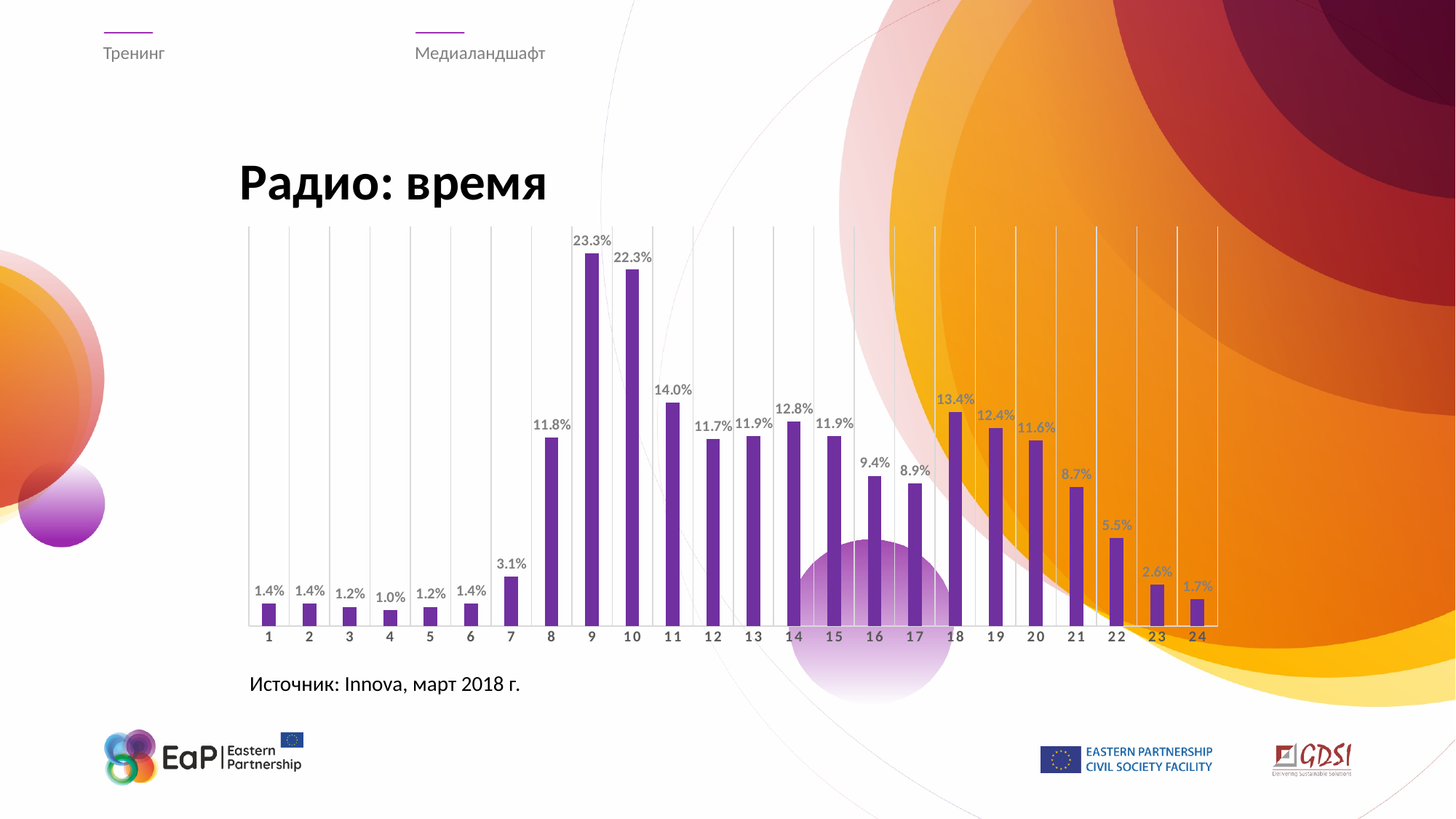
Which hour has the lowest value? 4 What is the value for hour 18? 13.4% What is the difference between the values for hour 18 and hour 17? 4.5% What is the value for hour 9? 23.3% What kind of chart is shown on the slide? bar chart What is the difference between the values for hour 9 and hour 10? 1.0% What is the title of the chart? Радио: время Which hour has the highest value? 9 How many hours (categories) are shown on the x axis? 24 Do the values rise or fall from hour 18 to hour 24? fall What is the value for hour 22? 5.5% Which is larger, the value for hour 11 or the value for hour 14? hour 11